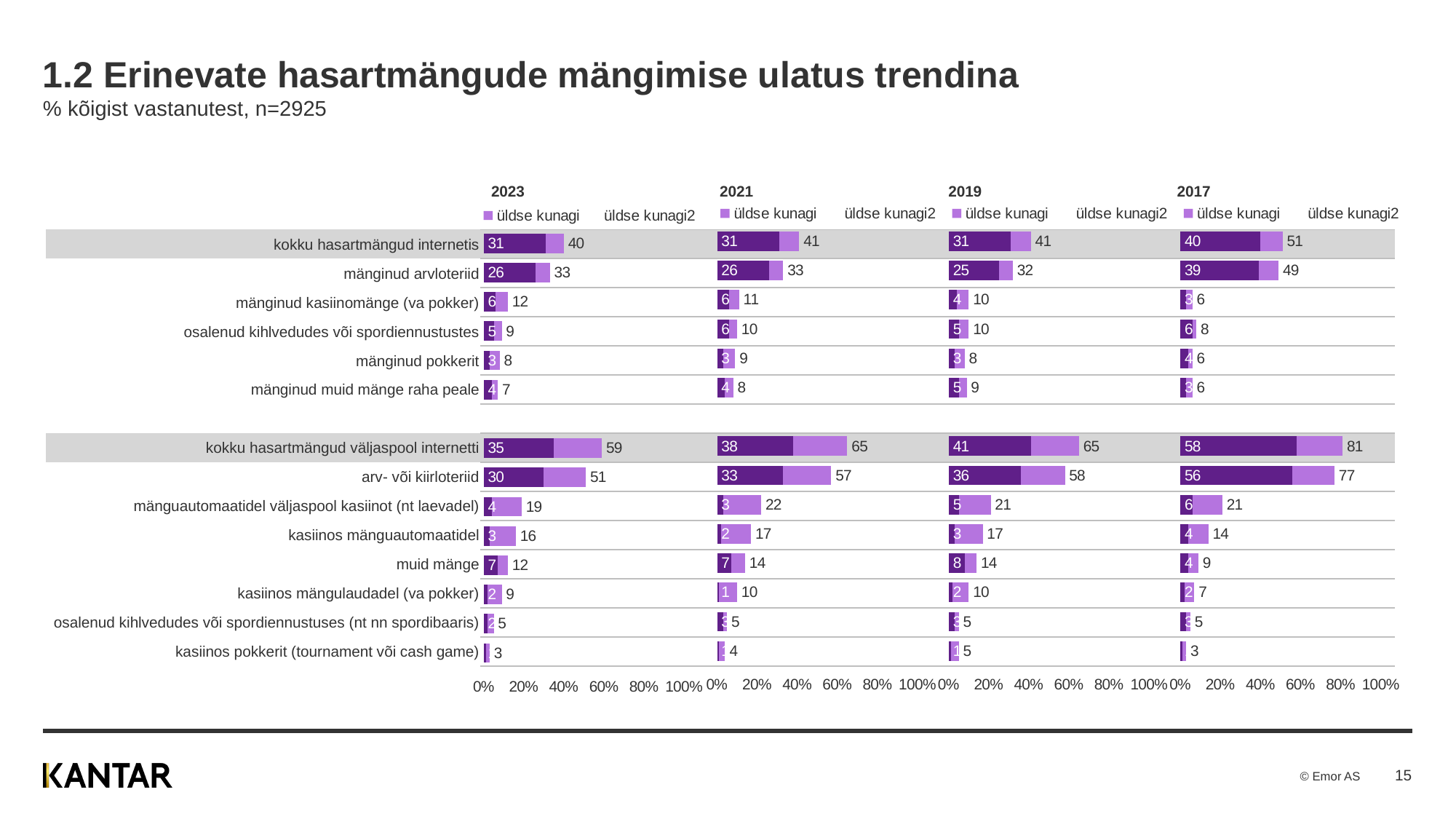
In the 2017 chart, does the bar for 'arv- või kiirloteriid' end at a value greater or less than 60%? greater Reading from the 2017 chart to the 2023 chart, does the dark-bar value for 'kokku hasartmängud väljaspool internetti' rise or fall? fall In the 2023 chart, which category has the lowest value printed at the end of its bar? kasiinos pokkerit (tournament või cash game) In the 2021 chart, what value is printed at the end of the bar for 'mänguautomaatidel väljaspool kasiinot (nt laevadel)'? 22 How many year charts are shown on the slide? 4 How many series does the legend of the 2023 chart list? 2 In the 2021 chart, which category has the highest value printed at the end of its bar? kokku hasartmängud väljaspool internetti Is the dark-bar value for 'mänginud arvloteriid' larger in the 2017 chart or in the 2023 chart? 2017 What kind of chart is used for the 2019 data? bar chart In the 2019 chart, what is the difference between the end-of-bar values for 'arv- või kiirloteriid' and 'kokku hasartmängud internetis'? 17 In the 2017 chart, what value is printed at the end of the bar for 'kokku hasartmängud väljaspool internetti'? 81 In the 2023 chart, what value is printed inside the dark bar for 'mänginud arvloteriid'? 26